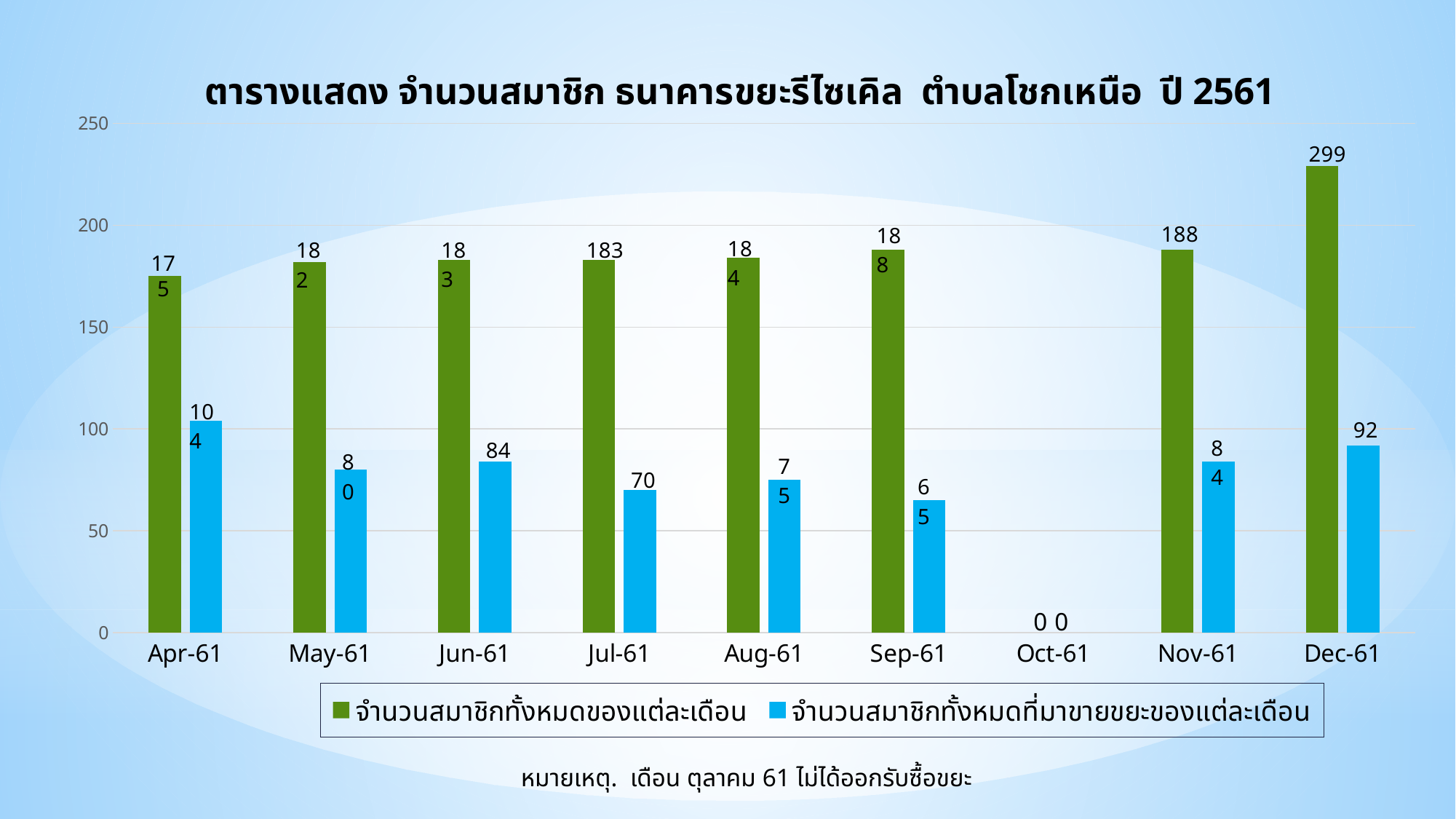
Is the value of จำนวนสมาชิกทั้งหมดที่มาขายขยะของแต่ละเดือน for Sep-61 greater or less than 50? greater Which month has the highest value for จำนวนสมาชิกทั้งหมดของแต่ละเดือน? Dec-61 What is the value of จำนวนสมาชิกทั้งหมดที่มาขายขยะของแต่ละเดือน for Jul-61? 70 How many months are shown on the x axis? 9 What is the value of จำนวนสมาชิกทั้งหมดของแต่ละเดือน for Nov-61? 188 What type of chart is shown on the slide? Bar chart Which is larger for จำนวนสมาชิกทั้งหมดที่มาขายขยะของแต่ละเดือน: Jun-61 or Jul-61? Jun-61 What is the value of จำนวนสมาชิกทั้งหมดของแต่ละเดือน for Jul-61? 183 Which month has the lowest value for จำนวนสมาชิกทั้งหมดที่มาขายขยะของแต่ละเดือน? Oct-61 How many series does the legend list? 2 What is the difference between the จำนวนสมาชิกทั้งหมดของแต่ละเดือน values for Nov-61 and Jul-61? 5 What is the value of จำนวนสมาชิกทั้งหมดที่มาขายขยะของแต่ละเดือน for Dec-61? 92